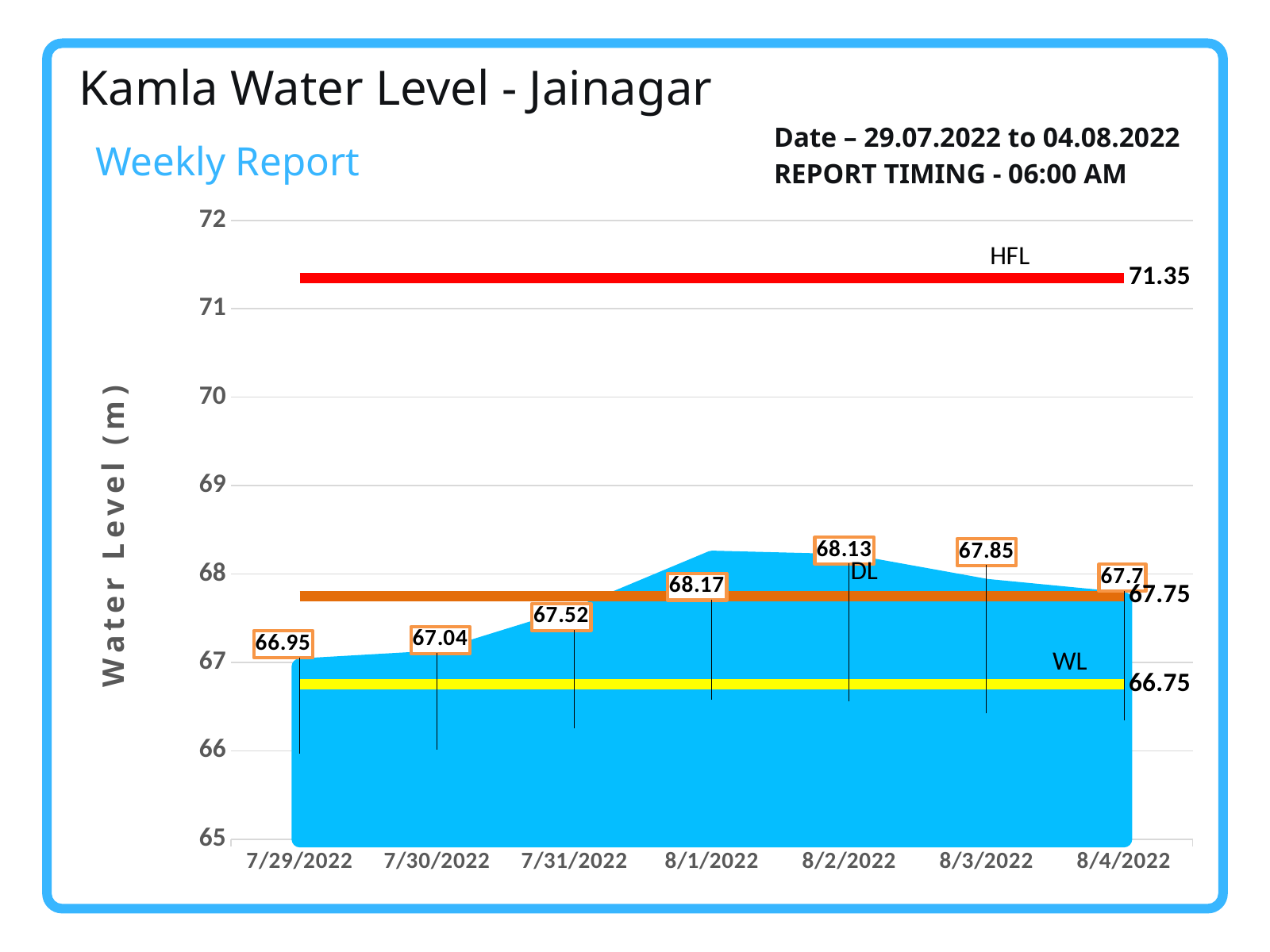
What value is shown for the DL line? 67.75 What is the water level on 8/1/2022? 68.17 What is the difference between the water level on 8/1/2022 and on 7/29/2022? 1.22 Which is larger, the water level on 7/31/2022 or on 8/3/2022? 8/3/2022 How many dates are plotted on the x axis? 7 On which date is the water level lowest? 7/29/2022 On which date is the water level highest? 8/1/2022 What is the water level on 8/4/2022? 67.7 What value is shown for the HFL line? 71.35 What kind of chart is shown on the slide? Area chart What is the water level on 7/29/2022? 66.95 What is the title of the slide's chart? Kamla Water Level - Jainagar